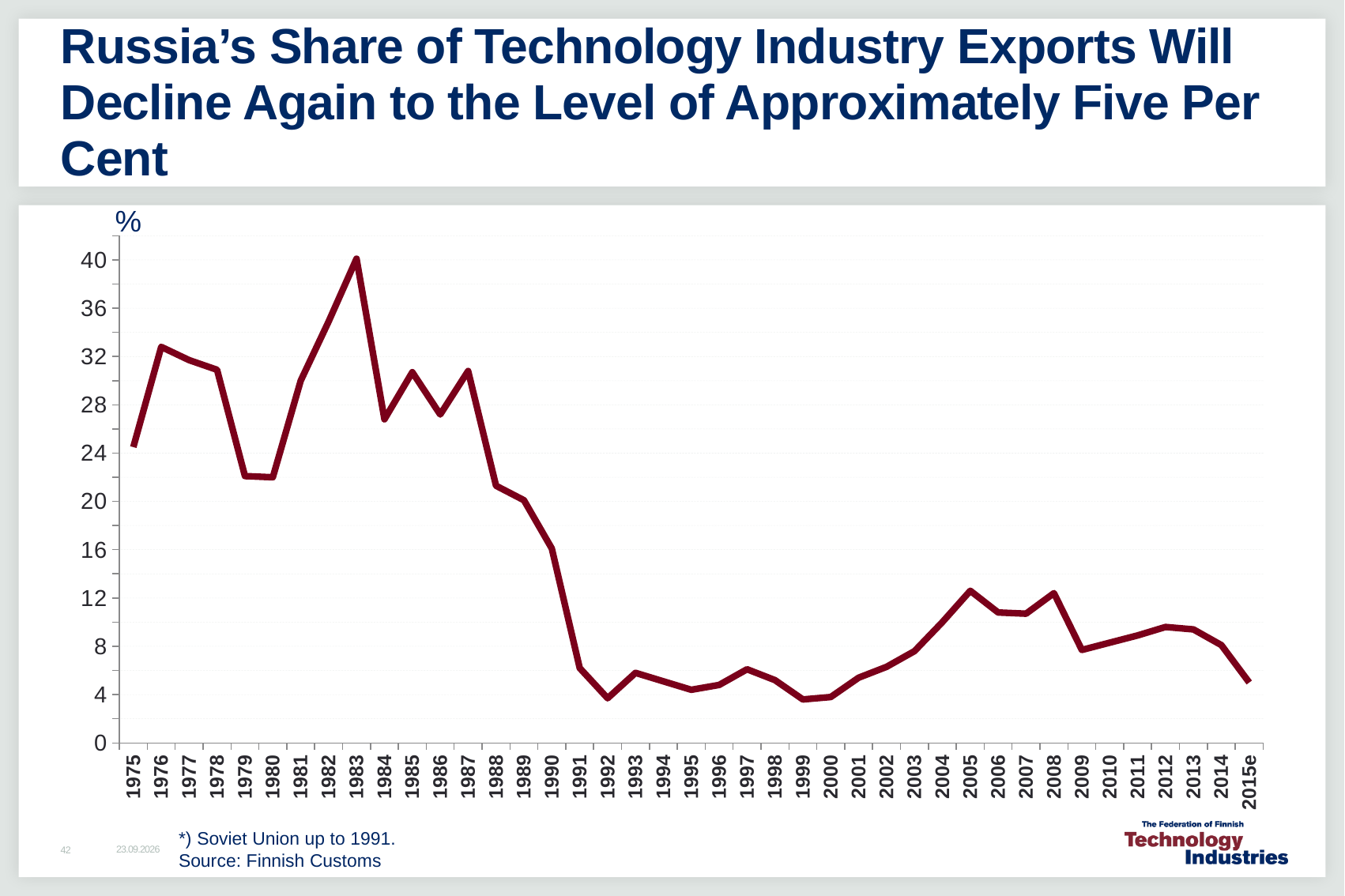
Which year has the larger value, 1976 or 1983? 1983 Is the value for 1992 greater or less than 8? less Is the value for 2005 greater or less than 8? greater Is the value for 2015e greater or less than 8? less What unit is shown on the y axis of the chart? % Which year has the larger value, 2000 or 2005? 2005 What kind of chart is shown on the slide? line chart In which year does Russia's share of technology industry exports reach its highest value? 1983 How many years (data points) are plotted along the x axis? 41 Does the share rise or fall between 1987 and 1992? fall